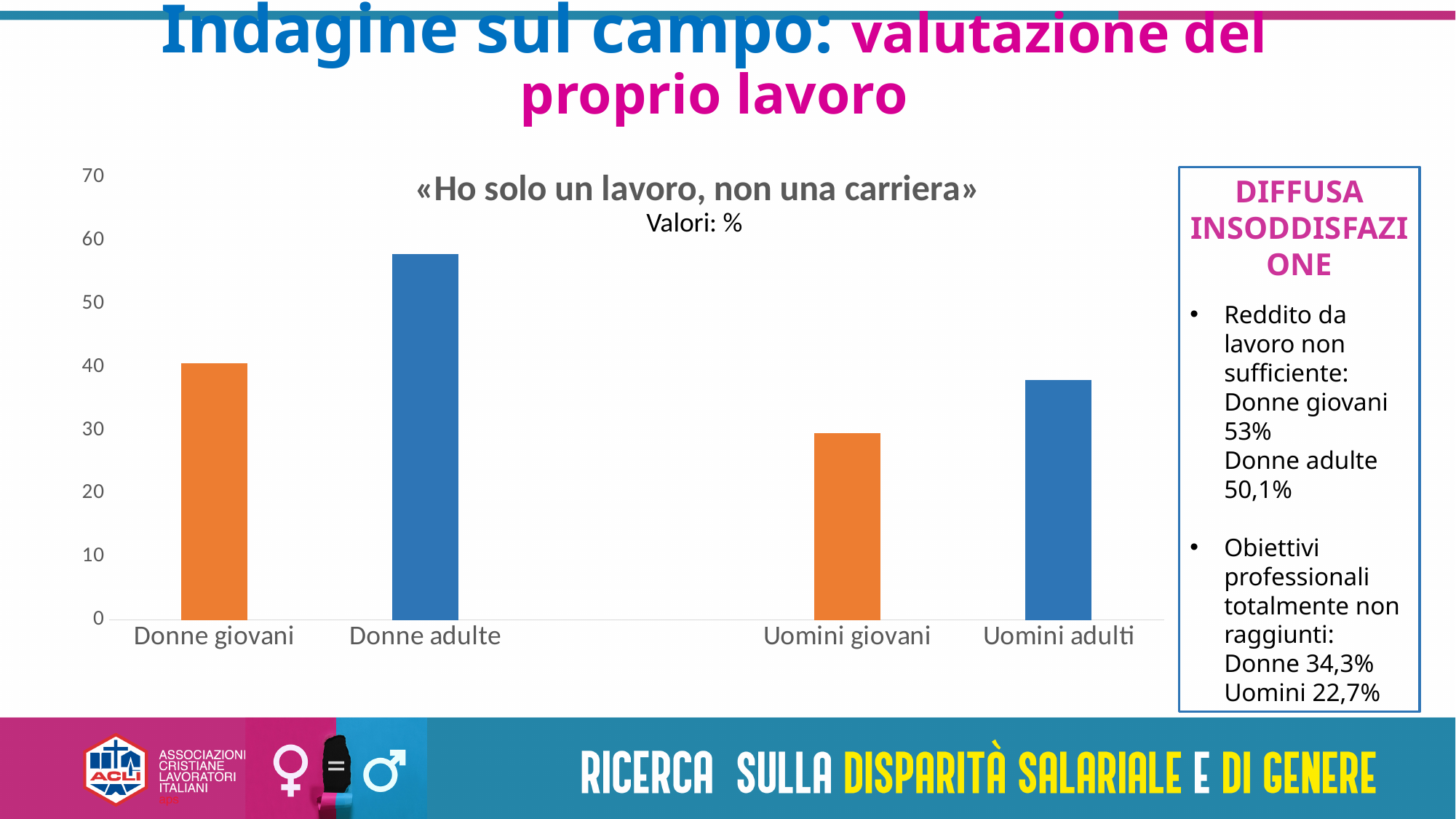
Is the value for Uomini giovani greater or less than 40? less Which category has the highest bar in the chart? Donne adulte What kind of chart is shown on the slide? bar chart Which is larger, the value for Donne giovani or the value for Uomini giovani? Donne giovani What is the title of the chart? «Ho solo un lavoro, non una carriera» Which is larger, the value for Donne adulte or the value for Uomini adulti? Donne adulte How many categories are shown on the x axis of the chart? 4 Is the value for Donne adulte greater or less than 60? less Is the value for Donne adulte greater or less than 50? greater Which category has the lowest bar in the chart? Uomini giovani